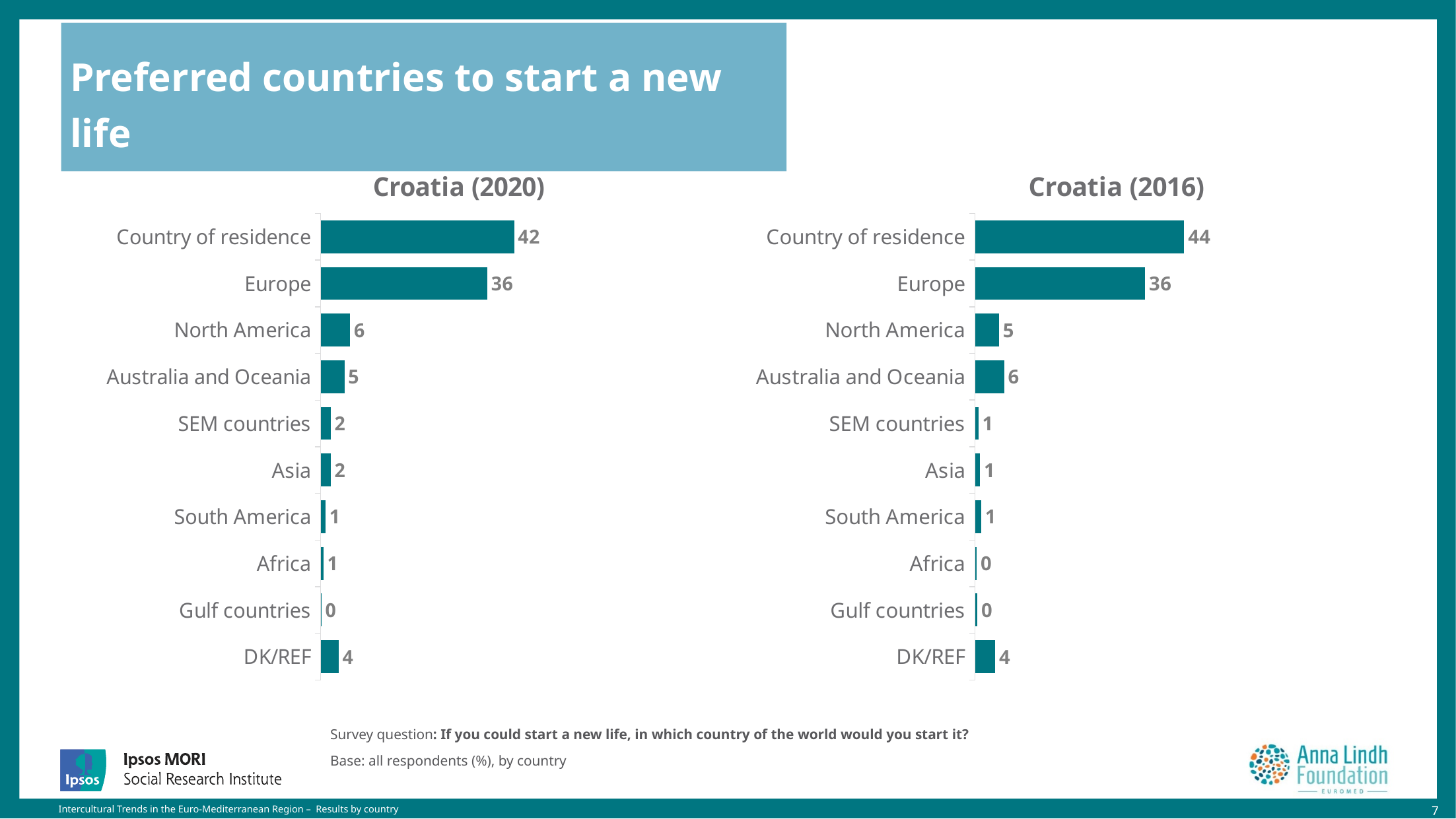
In the Croatia (2016) chart, what is the difference between Country of residence and Europe? 8 In the Croatia (2016) chart, which category has the highest value? Country of residence In the Croatia (2016) chart, which is larger: North America or Australia and Oceania? Australia and Oceania In the Croatia (2016) chart, what is the value for DK/REF? 4 In the Croatia (2020) chart, what is the value for Europe? 36 In the Croatia (2020) chart, what is the difference between Country of residence and Europe? 6 How many categories are shown in the Croatia (2020) chart? 10 What type of chart is the Croatia (2016) chart? Bar chart In the Croatia (2016) chart, what is the value for Country of residence? 44 What is the title of the chart on the left side of the slide? Croatia (2020) In the Croatia (2020) chart, what is the value for North America? 6 In the Croatia (2020) chart, which category has the highest value? Country of residence